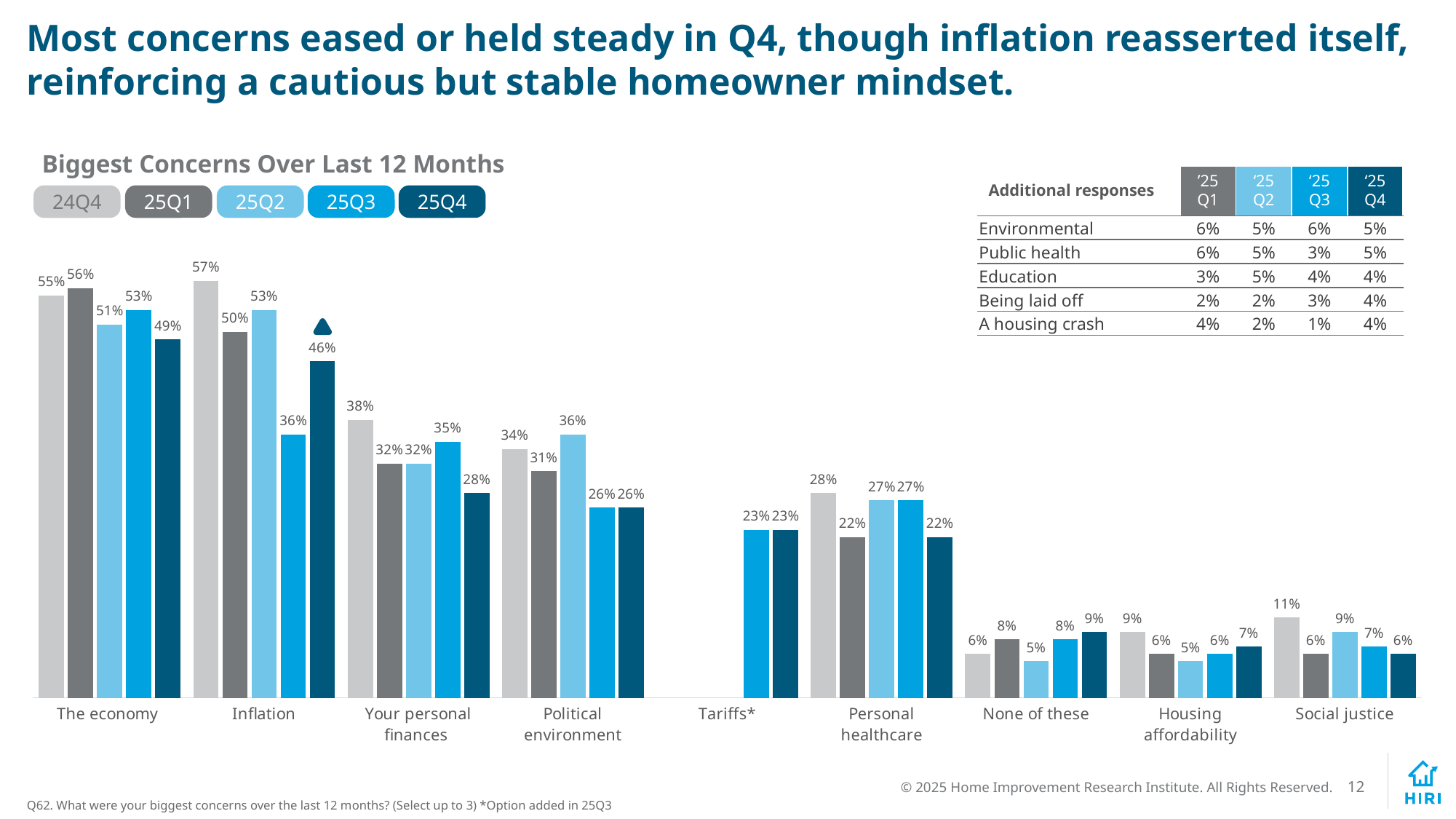
What is the 24Q4 value for Your personal finances? 38% What kind of chart is shown on the slide? Bar chart In the Additional responses table, what is the '25 Q4 value for A housing crash? 4% Which category has the highest 25Q4 value? The economy How many categories are shown on the x axis of the chart? 9 What is the difference between the 25Q3 and 25Q4 values for Inflation? 10% Do the values for The economy rise or fall from 25Q3 to 25Q4? Fall Which is larger for Personal healthcare: the 24Q4 value or the 25Q4 value? 24Q4 How many series does the legend list? 5 What is the 25Q2 value for Political environment? 36% What is the 25Q4 value for Inflation? 46%